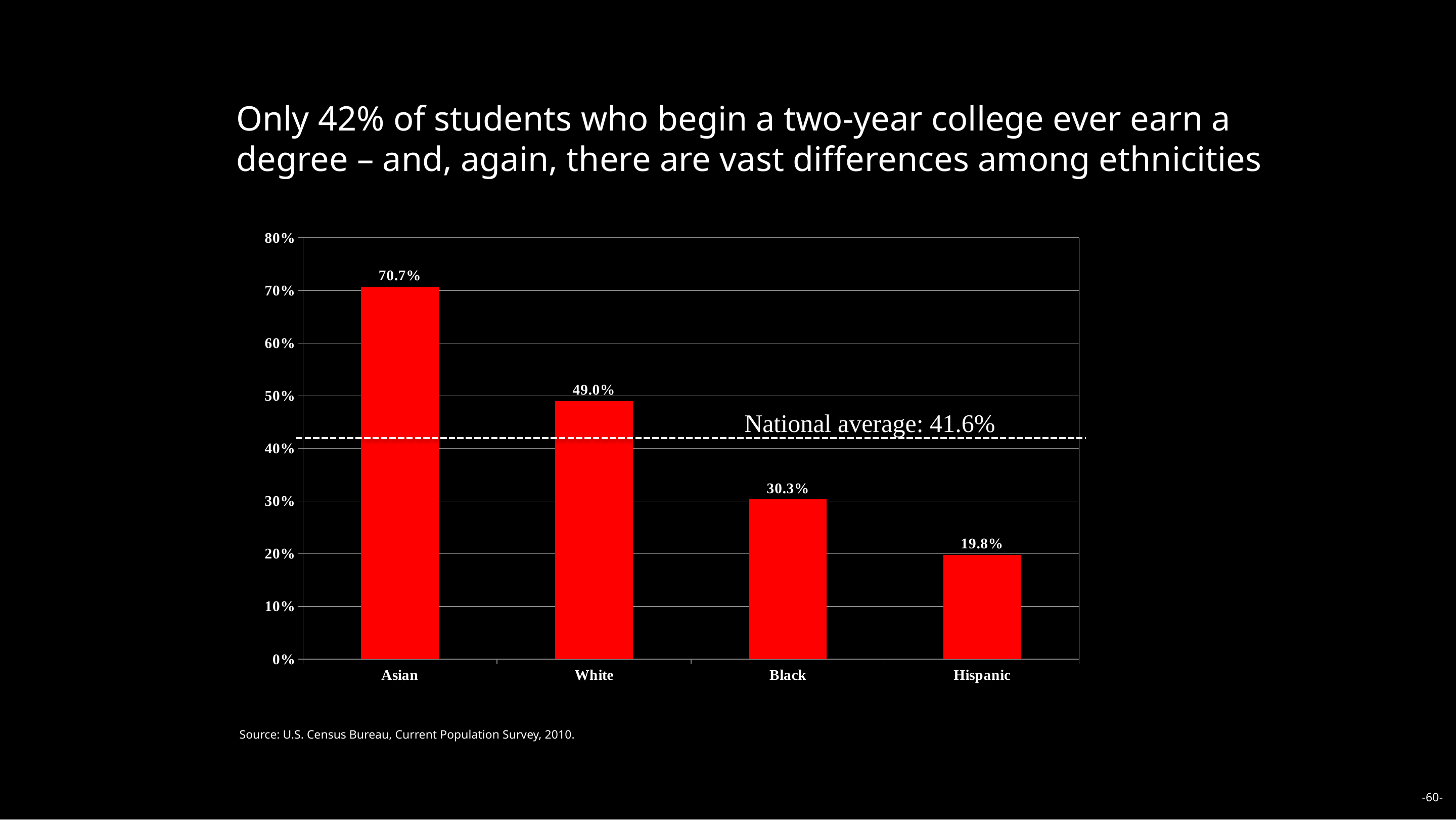
What is the value for Hispanic? 19.8% What is the difference between the values for Asian and Hispanic? 50.9% What is the value for Black? 30.3% What kind of chart is shown on the slide? Bar chart Which category has the lowest value? Hispanic How many categories are shown on the x axis? 4 Which is larger, the value for White or the value for Black? White What is the value for Asian? 70.7% Which category has the highest value? Asian What is the difference between the values for White and Black? 18.7% What is the value for White? 49.0% What national average value is marked by the dashed line on the chart? 41.6%